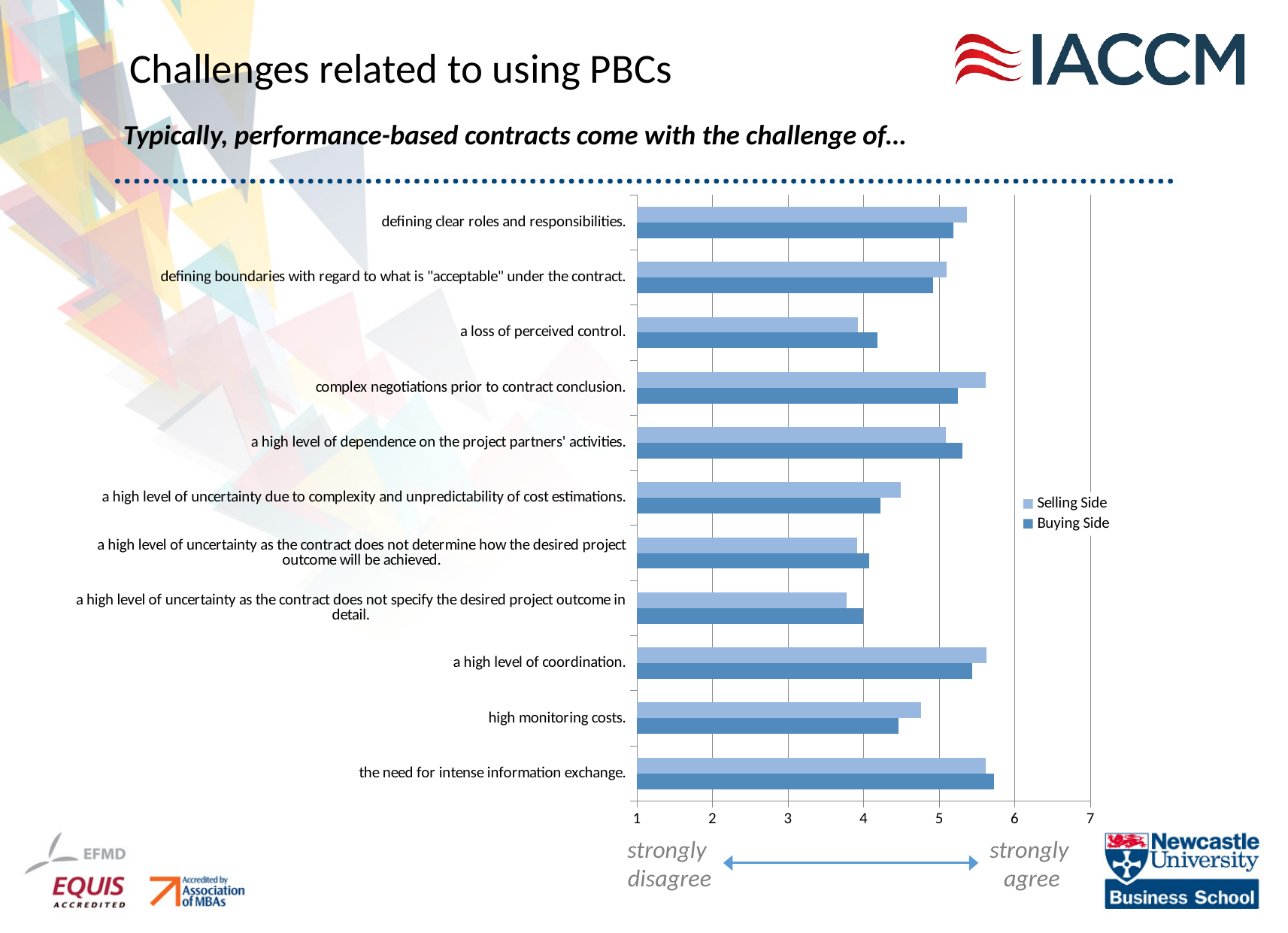
Is the Selling Side value for "complex negotiations prior to contract conclusion" greater or less than 5? greater For "high monitoring costs", which series has the larger value, Selling Side or Buying Side? Selling Side Is the Selling Side value for "a loss of perceived control" greater or less than 4? less For "complex negotiations prior to contract conclusion", which series has the larger value, Selling Side or Buying Side? Selling Side Is the Buying Side value for "high monitoring costs" greater or less than 5? less What are the two series named in the legend? Selling Side and Buying Side Which category has the highest Buying Side value? the need for intense information exchange. How many challenge categories are plotted on the chart? 11 What kind of chart is shown on the slide? bar chart How many series does the legend list? 2